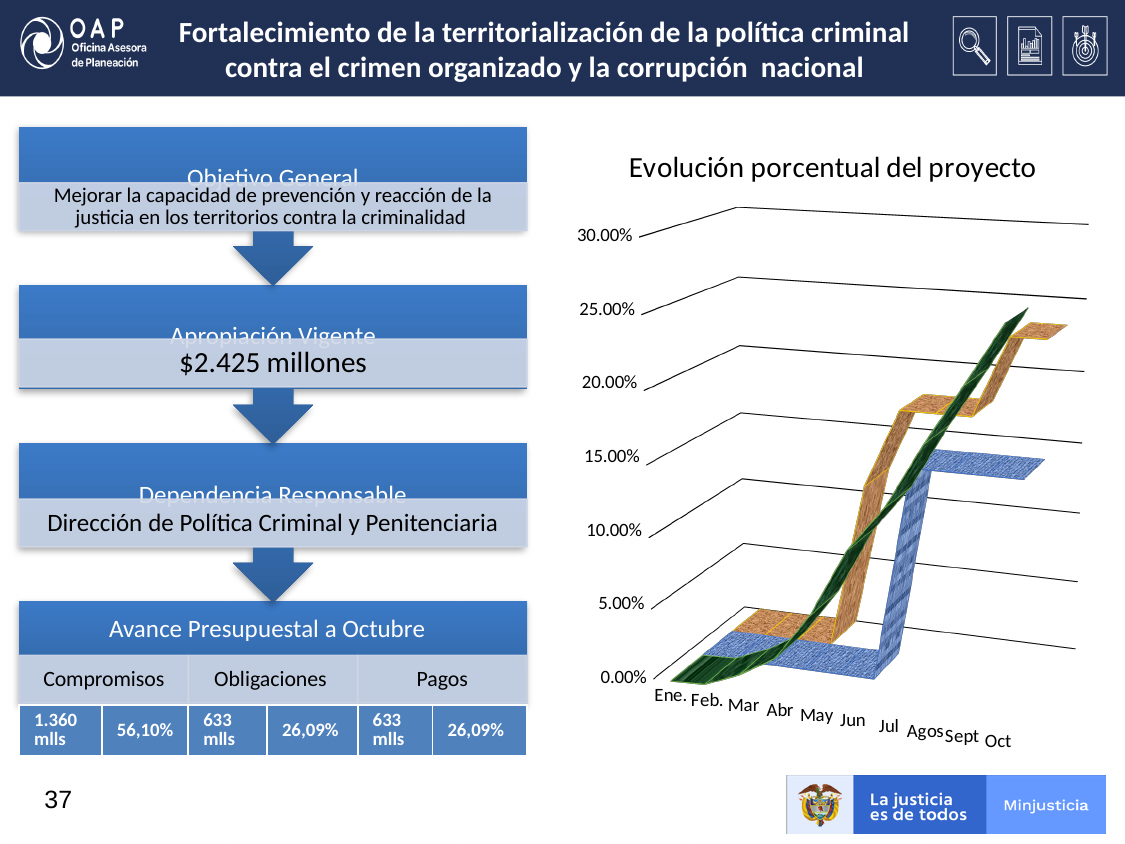
What is the lowest tick value shown on the vertical axis of the "Evolución porcentual del proyecto" chart? 0.00% How many months are shown along the x axis of the "Evolución porcentual del proyecto" chart? 10 What is the highest tick value shown on the vertical axis of the "Evolución porcentual del proyecto" chart? 30.00% How many coloured lines are plotted in the "Evolución porcentual del proyecto" chart? 3 What is the title of the chart on the right side of the slide? Evolución porcentual del proyecto What kind of chart is "Evolución porcentual del proyecto"? line chart What is the last category on the x axis of the "Evolución porcentual del proyecto" chart? Oct What is the first category on the x axis of the "Evolución porcentual del proyecto" chart? Ene. In the "Evolución porcentual del proyecto" chart, is the value for Ene. greater or less than 5.00%? less In the "Evolución porcentual del proyecto" chart, do the plotted values rise or fall from Ene. to Oct? rise In the "Evolución porcentual del proyecto" chart, which month has the highest values? Oct